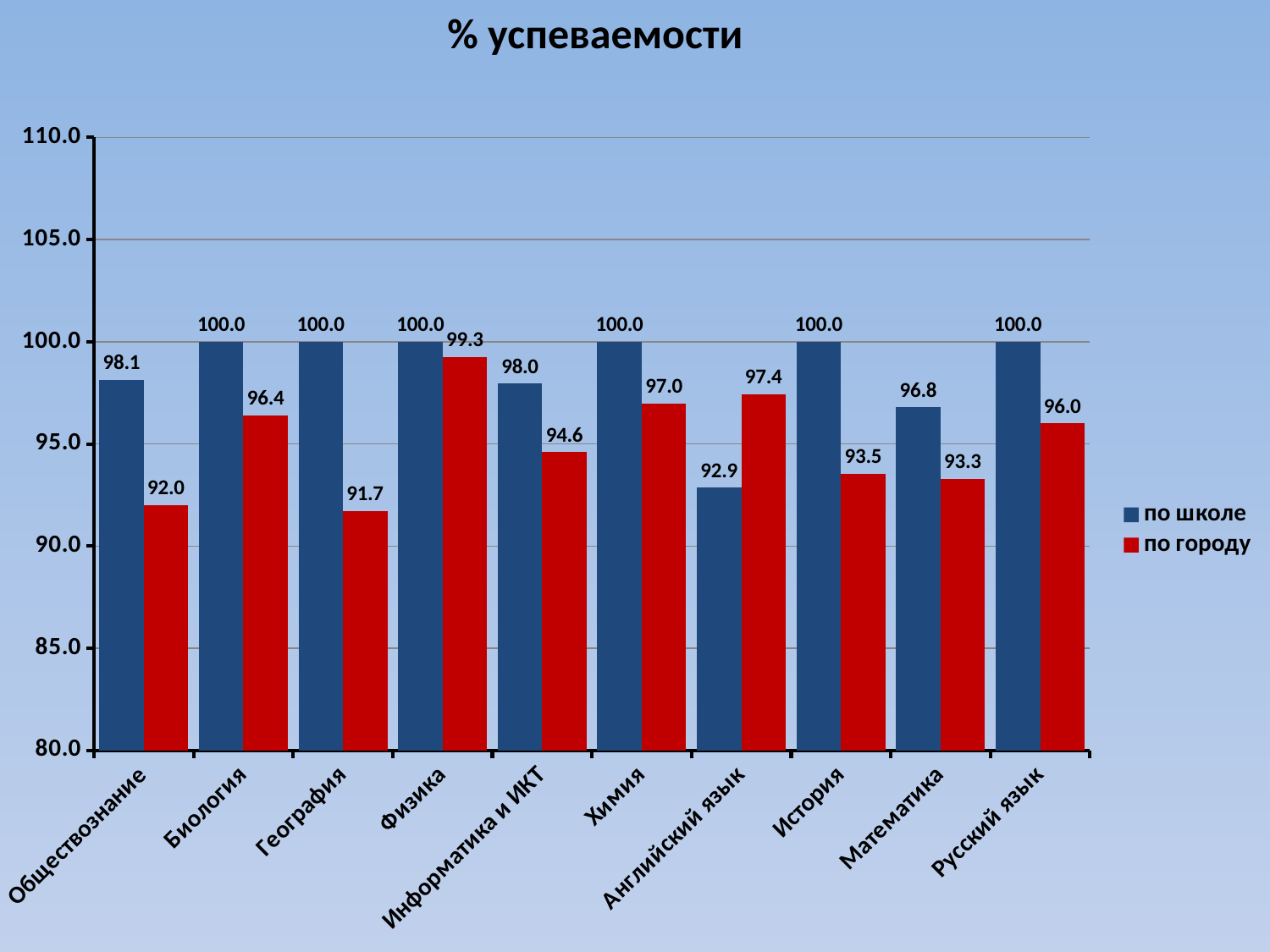
How many series does the legend list? 2 What is the value for "по городу" for Физика? 99.3 What is the value for "по городу" for География? 91.7 Which category has the highest value for "по городу"? Физика How many categories are shown on the x axis? 10 For Английский язык, which is larger: "по школе" or "по городу"? по городу Which category has the lowest value for "по городу"? География What is the difference between "по школе" and "по городу" for Обществознание? 6.1 What is the value for "по школе" for Математика? 96.8 What type of chart is shown on the slide? Bar chart What is the value for "по школе" for Обществознание? 98.1 Which category has the lowest value for "по школе"? Английский язык